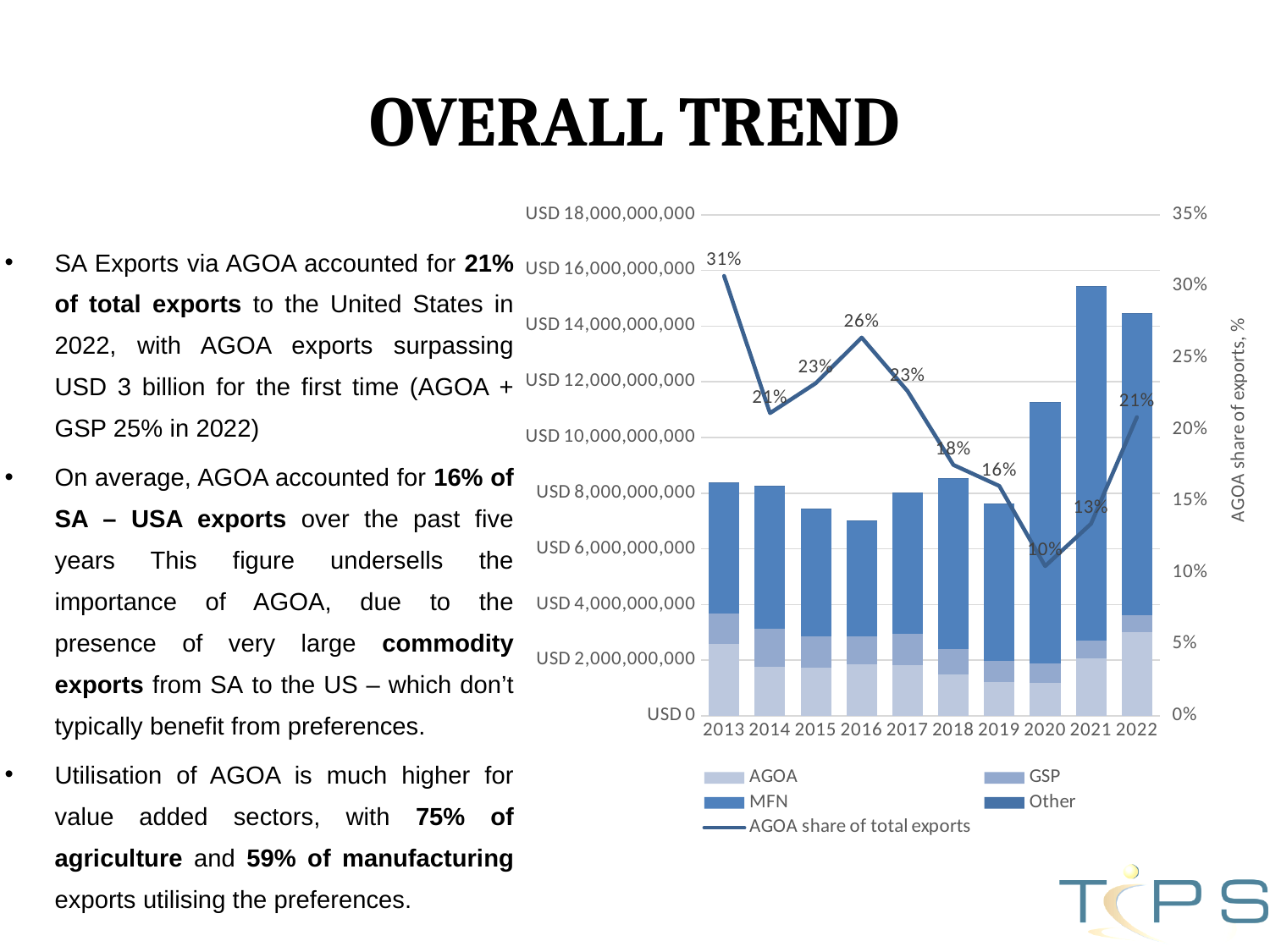
How many series does the chart legend list? 5 In which year is the AGOA share of total exports highest? 2013 Does the AGOA share of total exports rise or fall from 2016 to 2020? fall What is the difference in percentage points between the AGOA share of total exports in 2013 and in 2020? 21 percentage points Is the total value of the stacked bar for 2016 greater or less than USD 8,000,000,000? less What is the AGOA share of total exports in 2020? 10% In which year is the AGOA share of total exports lowest? 2020 What is the AGOA share of total exports in 2013? 31% How many years are shown on the x axis of the chart? 10 Is the total value of the stacked bar for 2021 greater or less than USD 14,000,000,000? greater Which year has a higher AGOA share of total exports, 2016 or 2017? 2016 What is the AGOA share of total exports in 2022? 21%